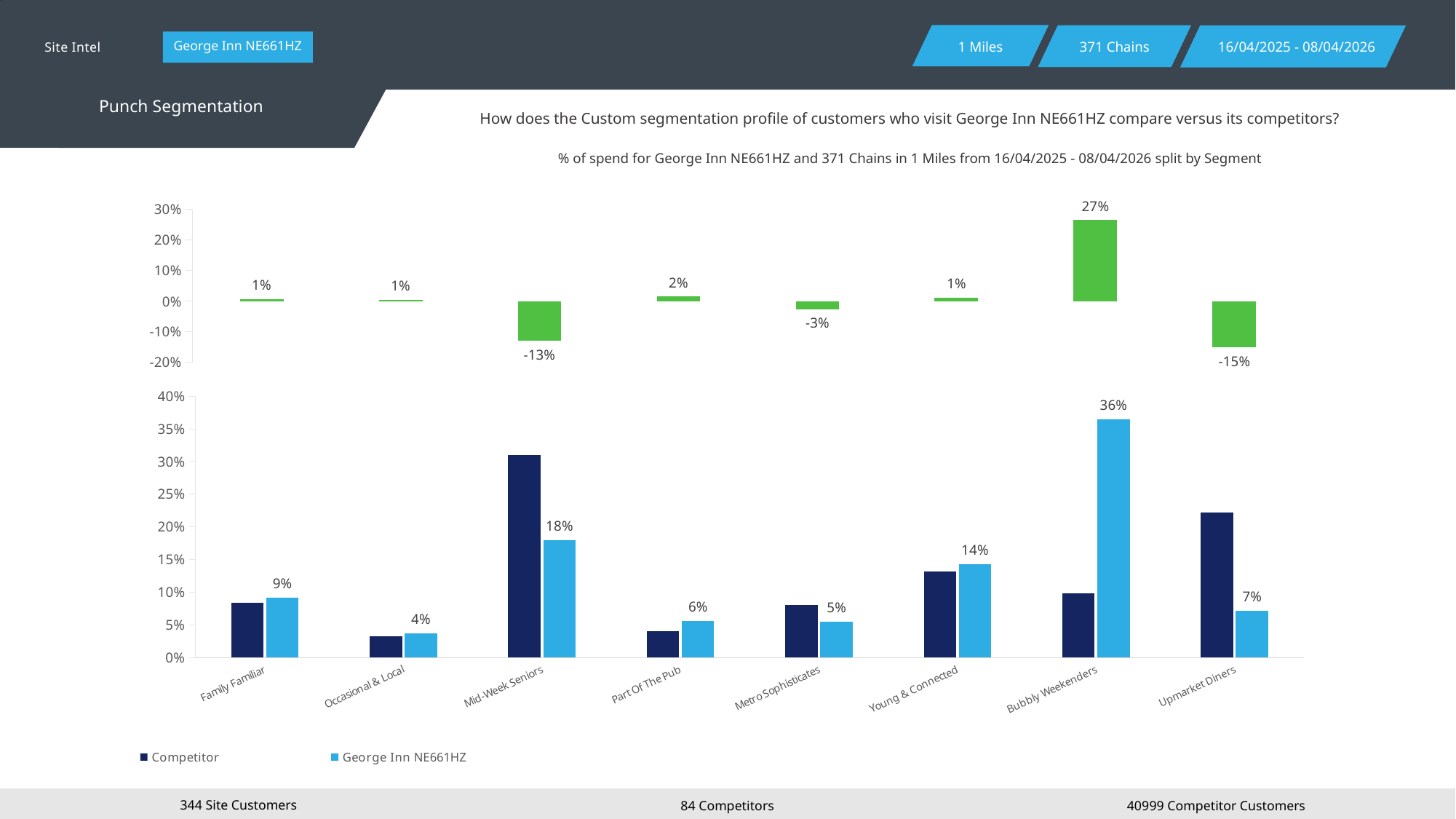
In the bottom chart, for Upmarket Diners, which is larger: the Competitor value or the George Inn NE661HZ value? Competitor In the top chart, which segment has the highest value? Bubbly Weekenders In the bottom chart, which segment has the lowest George Inn NE661HZ value? Occasional & Local In the top chart, which segment has the lowest value? Upmarket Diners In the bottom chart, what is the difference between the George Inn NE661HZ values for Bubbly Weekenders and Young & Connected? 22% How many series does the legend of the bottom chart list? 2 In the bottom chart, what is the George Inn NE661HZ value for Mid-Week Seniors? 18% In the top chart, what is the value shown for Upmarket Diners? -15% In the bottom chart, is the Competitor value for Mid-Week Seniors greater or less than 25%? greater What type of chart is the bottom chart? Bar chart In the bottom chart, what is the George Inn NE661HZ value for Bubbly Weekenders? 36% How many segments are shown on the x axis of the bottom chart? 8